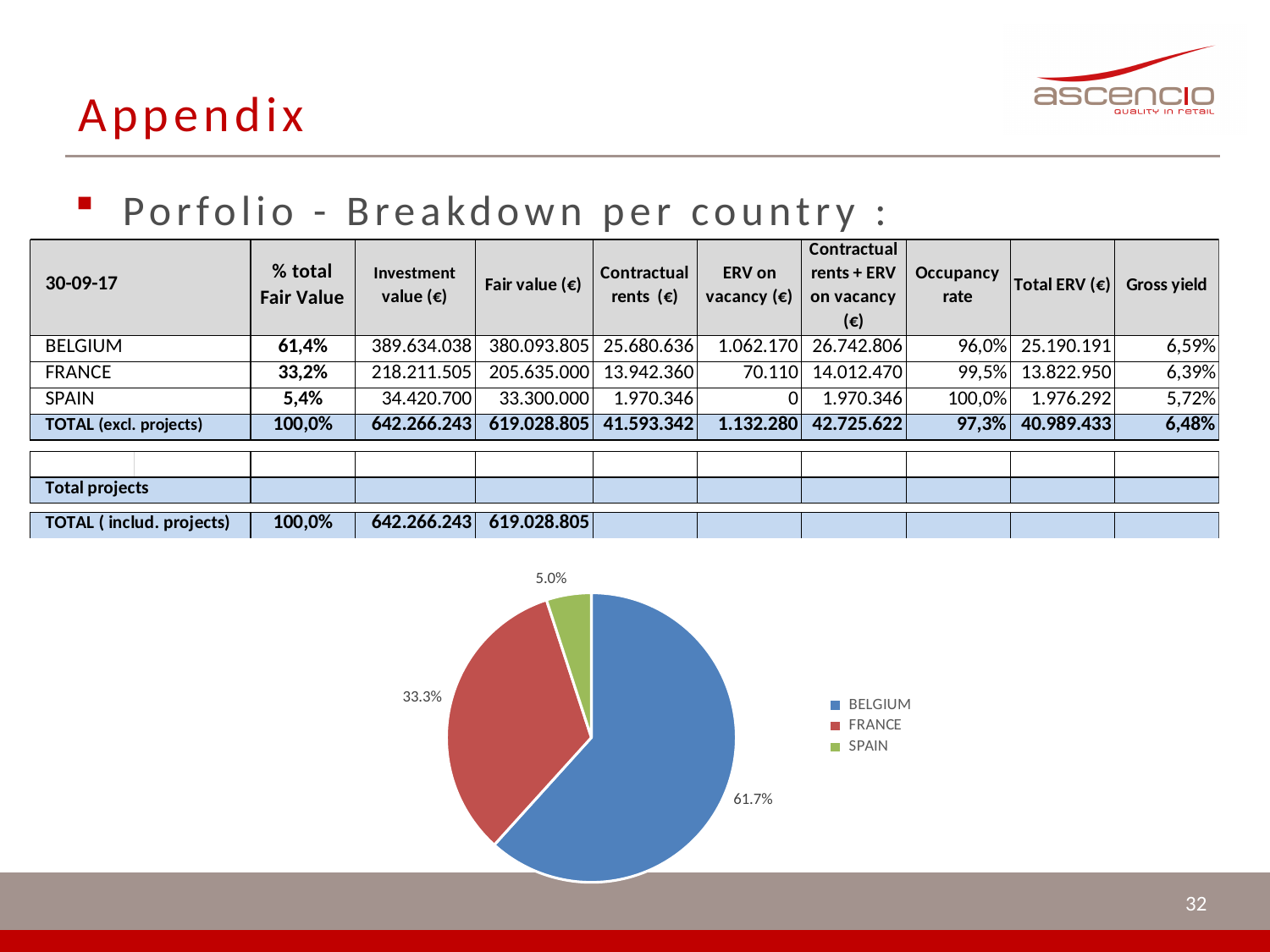
Which country has the largest slice of the pie? BELGIUM How many entries does the pie chart legend list? 3 What colour is the BELGIUM slice in the pie chart? blue Which country has the smallest slice of the pie? SPAIN What colour is the SPAIN slice in the pie chart? green What share of the pie does FRANCE have? 33.3% How many slices does the pie chart have? 3 What kind of chart is shown on the slide? pie chart What share of the pie does SPAIN have? 5.0% What share of the pie does BELGIUM have? 61.7% Which slice is larger in the pie chart, FRANCE or SPAIN? FRANCE What is the difference in percentage points between the BELGIUM and FRANCE slices? 28.4